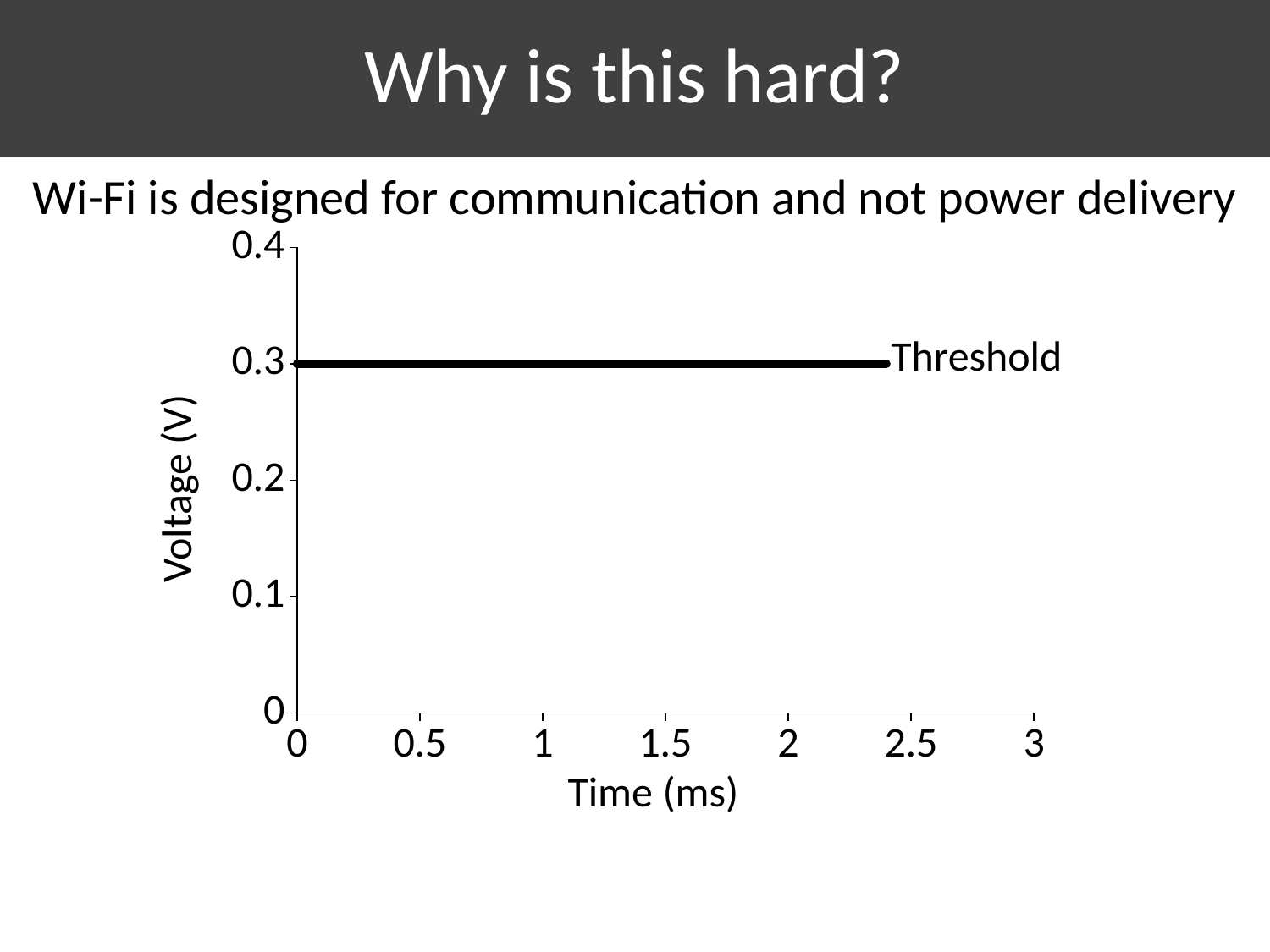
What is the highest tick value shown on the y axis? 0.4 What is the highest tick value shown on the x axis? 3 Is the Threshold line greater or less than 0.2 V? greater Does the Threshold line rise, fall, or stay flat as time increases? stays flat What is the label of the line plotted on the chart? Threshold How many lines are plotted on the chart? 1 What kind of chart is shown on the slide? line chart What voltage does the Threshold line sit at? 0.3 What is the label of the y axis? Voltage (V) Is the Threshold line greater or less than 0.4 V? less